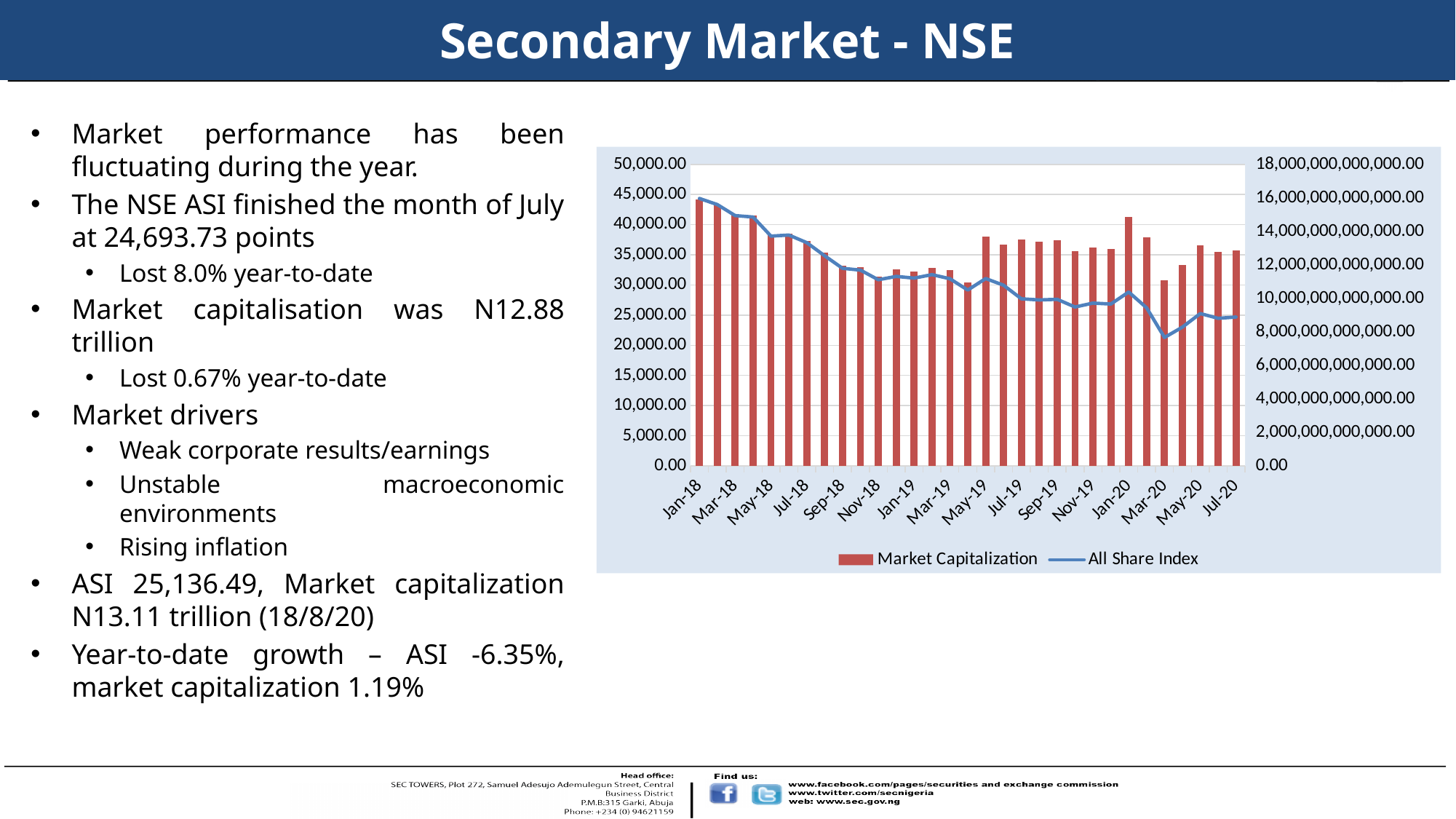
Which is larger, the All Share Index in Jan-18 or in Jul-20? Jan-18 Which series is plotted as bars in the chart? Market Capitalization In which month is the All Share Index line at its lowest? Mar-20 Is the All Share Index value for Jan-18 greater or less than 40,000.00? greater Is the All Share Index value for Mar-20 greater or less than 25,000.00? less Does the All Share Index line rise or fall from Jan-18 to Nov-18? fall Which series is plotted as a line in the chart? All Share Index In which month is the All Share Index line at its highest? Jan-18 Is the Market Capitalization value for Jan-18 greater or less than 14,000,000,000,000.00? greater How many series does the chart legend list? 2 What kind of chart is shown on the slide? A combination bar and line chart